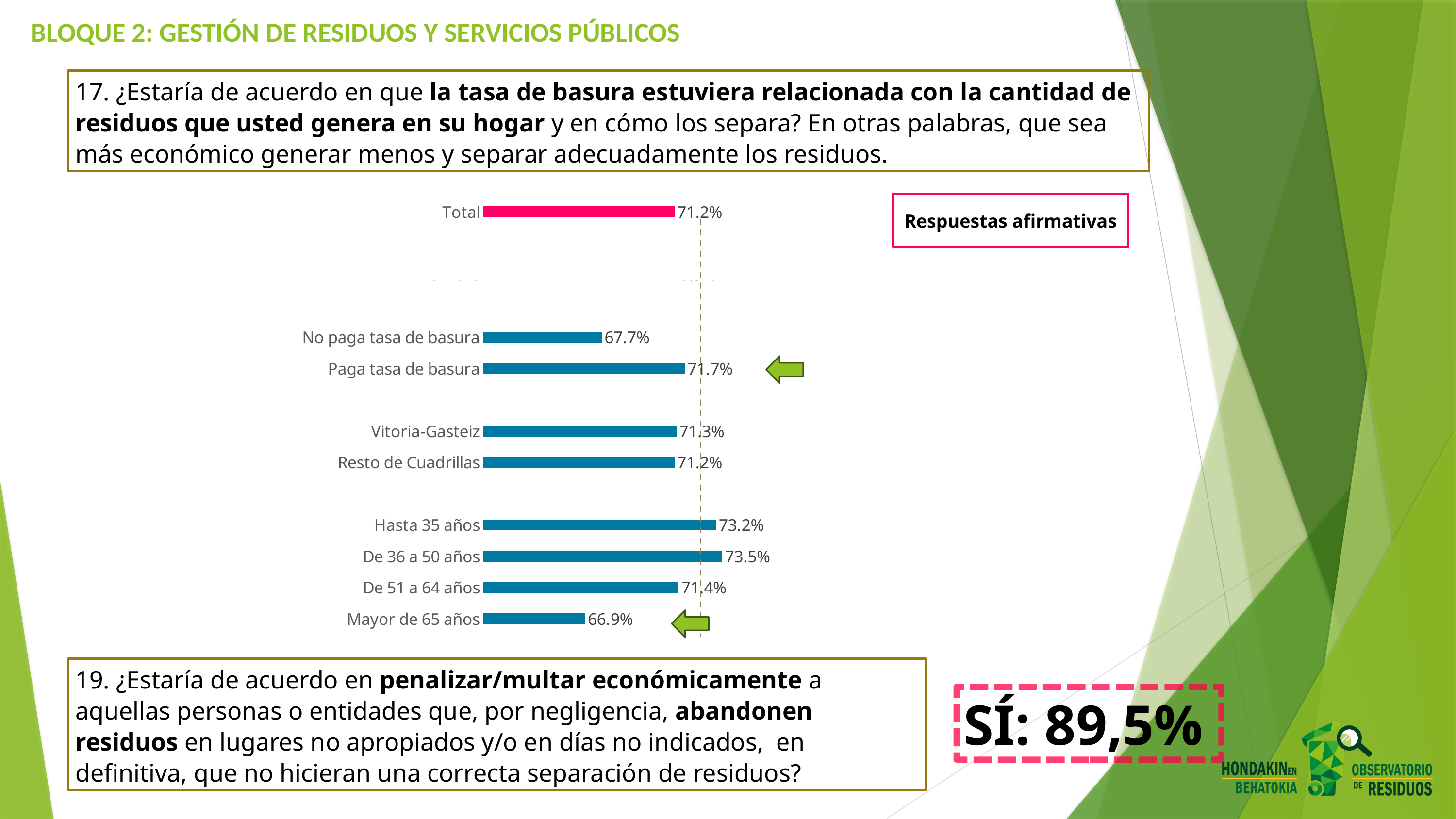
Which category has the highest value? De 36 a 50 años What is the value for Vitoria-Gasteiz? 71.3% What is the value for Total? 71.2% What is the value for Mayor de 65 años? 66.9% Which category has the lowest value? Mayor de 65 años Which is larger, Hasta 35 años or Mayor de 65 años? Hasta 35 años How many bars are plotted in the chart? 9 What colour is the Total bar? Pink What is the value for No paga tasa de basura? 67.7% What is the value for Paga tasa de basura? 71.7% What is the difference between Paga tasa de basura and No paga tasa de basura? 4.0 percentage points What kind of chart is shown? Bar chart